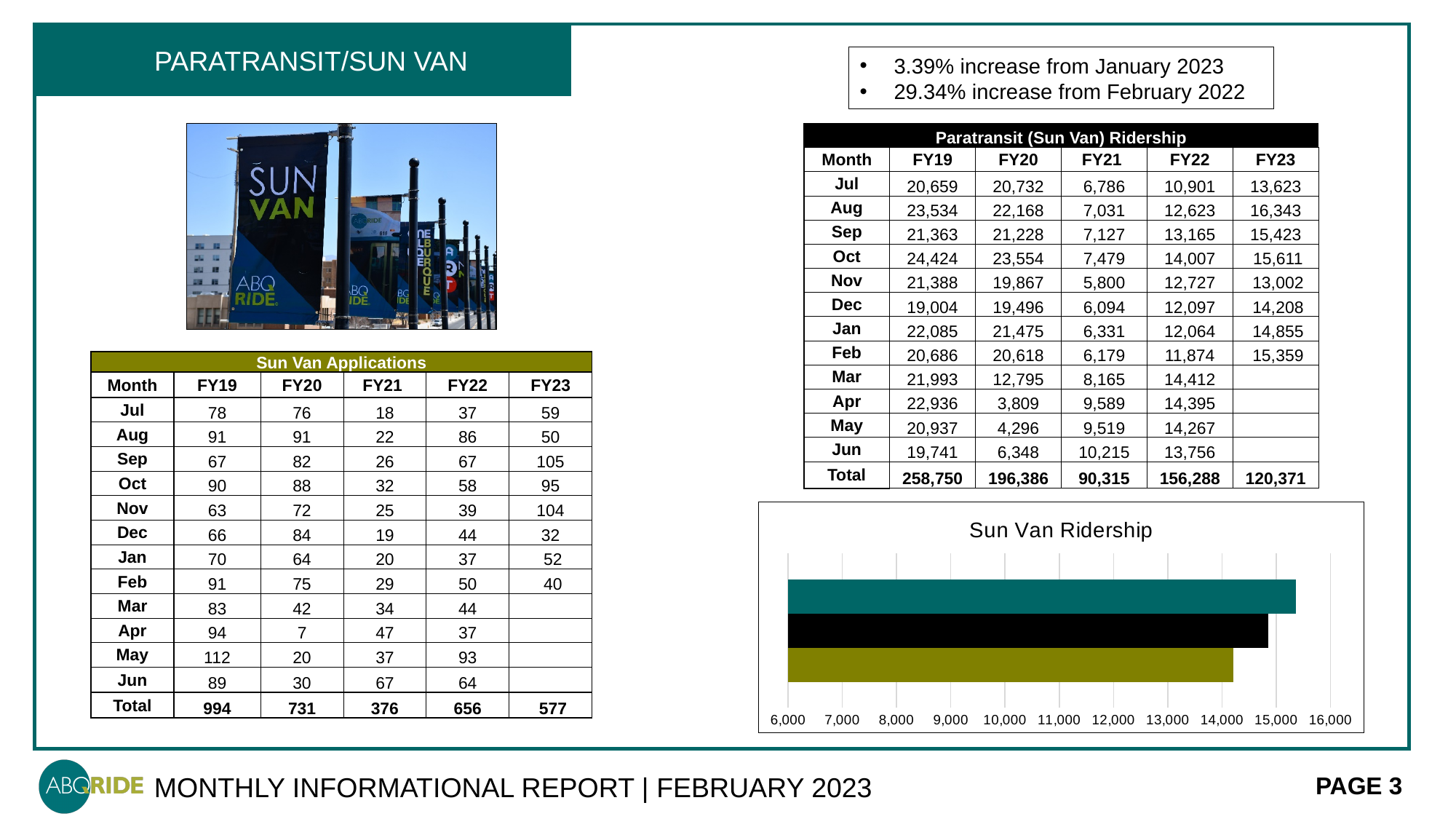
What kind of chart is the "Sun Van Ridership" chart? bar chart In the "Sun Van Ridership" chart, which bar is the longest: the top, middle, or bottom bar? top In the "Sun Van Ridership" chart, is the bottom (olive) bar greater or less than 13,000? greater In the "Sun Van Ridership" chart, which bar is the shortest: the top, middle, or bottom bar? bottom In the "Sun Van Ridership" chart, is the middle (black) bar greater or less than 13,000? greater In the "Sun Van Ridership" chart, is the bottom (olive) bar greater or less than 15,000? less How many bars are plotted in the "Sun Van Ridership" chart? 3 In the "Sun Van Ridership" chart, which is larger: the middle bar or the bottom bar? middle bar In the "Sun Van Ridership" chart, which is larger: the top bar or the bottom bar? top bar What is the highest value shown on the x axis of the "Sun Van Ridership" chart? 16,000 What is the title of the chart on the slide? Sun Van Ridership